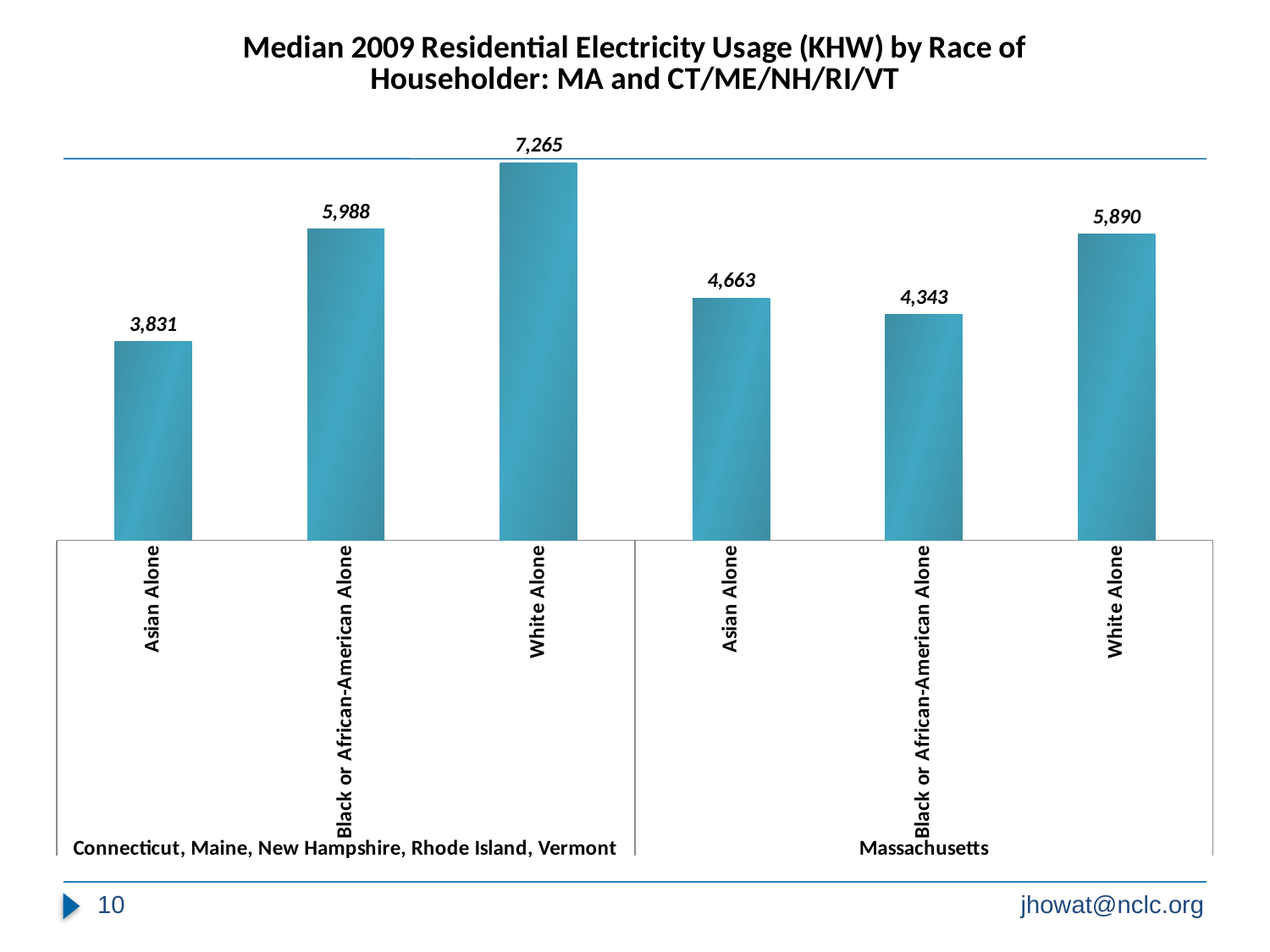
What is the median 2009 residential electricity usage for Asian Alone householders in Massachusetts? 4,663 Which is larger: the Asian Alone value in Massachusetts or the Asian Alone value in CT/ME/NH/RI/VT? Massachusetts How many bars are plotted on the chart? 6 What is the difference between the White Alone values for the CT/ME/NH/RI/VT group and Massachusetts? 1,375 What is the title of the chart? Median 2009 Residential Electricity Usage (KHW) by Race of Householder: MA and CT/ME/NH/RI/VT What kind of chart is shown on the slide? Bar chart Which is larger in Massachusetts: Asian Alone or Black or African-American Alone? Asian Alone What is the difference between the Black or African-American Alone value and the Asian Alone value in the CT/ME/NH/RI/VT group? 2,157 What is the median 2009 residential electricity usage for White Alone householders in Connecticut, Maine, New Hampshire, Rhode Island, Vermont? 7,265 Which bar has the lowest value on the chart? Asian Alone (Connecticut, Maine, New Hampshire, Rhode Island, Vermont) What is the value for Black or African-American Alone householders in Massachusetts? 4,343 Which bar has the highest value on the chart? White Alone (Connecticut, Maine, New Hampshire, Rhode Island, Vermont)